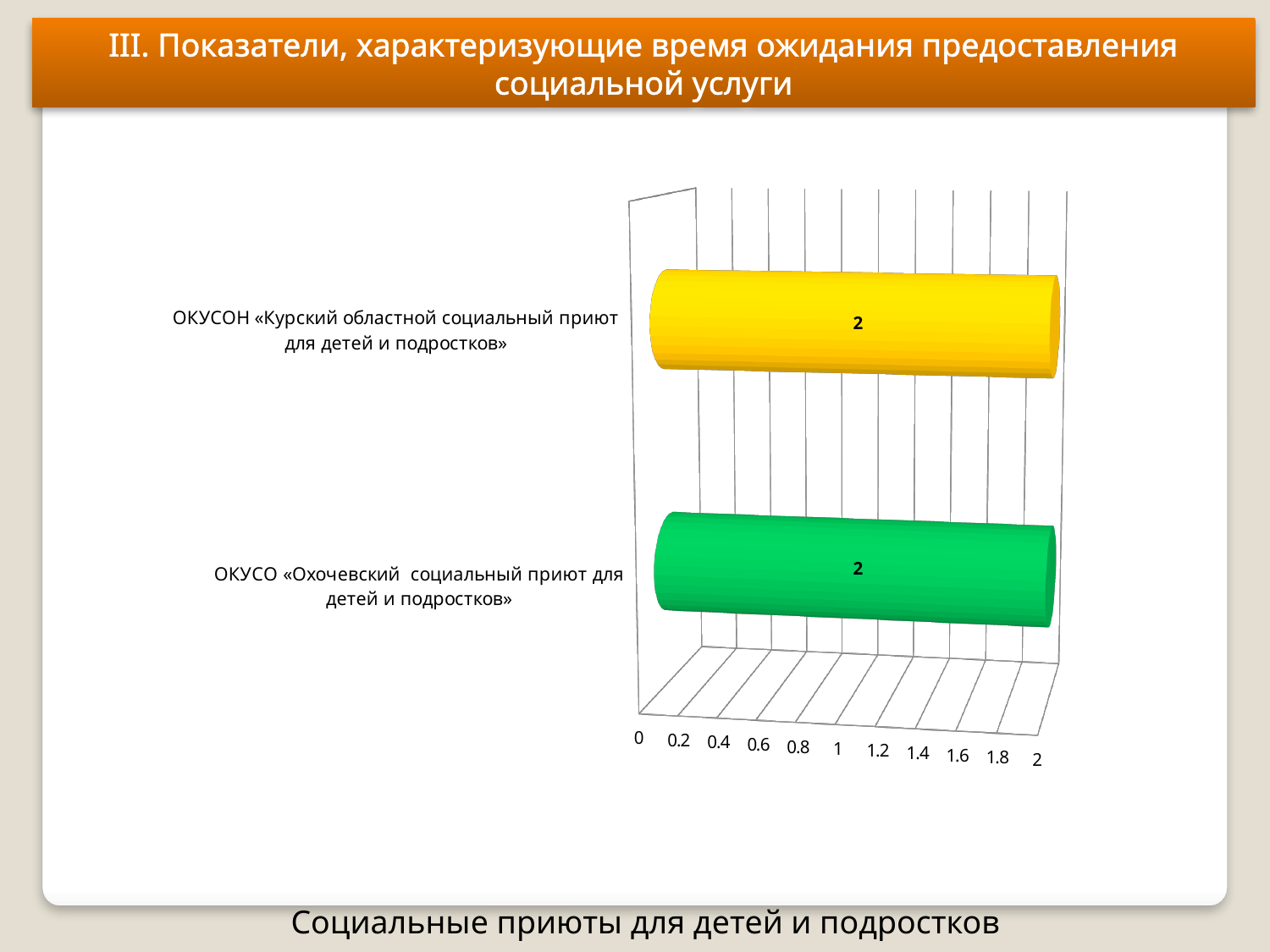
Is the value for ОКУСО «Охочевский социальный приют для детей и подростков» greater or less than 1? greater What is the maximum value shown on the chart's value axis? 2 How many categories are plotted in the chart? 2 What is the value for ОКУСО «Охочевский социальный приют для детей и подростков»? 2 What kind of chart is shown on the slide? Bar chart What is the value for ОКУСОН «Курский областной социальный приют для детей и подростков»? 2 What colour is the bar for ОКУСО «Охочевский социальный приют для детей и подростков»? Green Is the value for ОКУСОН «Курский областной социальный приют для детей и подростков» greater or less than 1.5? greater Do the two categories have the same value? Yes What is the difference between the values for ОКУСОН «Курский областной социальный приют для детей и подростков» and ОКУСО «Охочевский социальный приют для детей и подростков»? 0